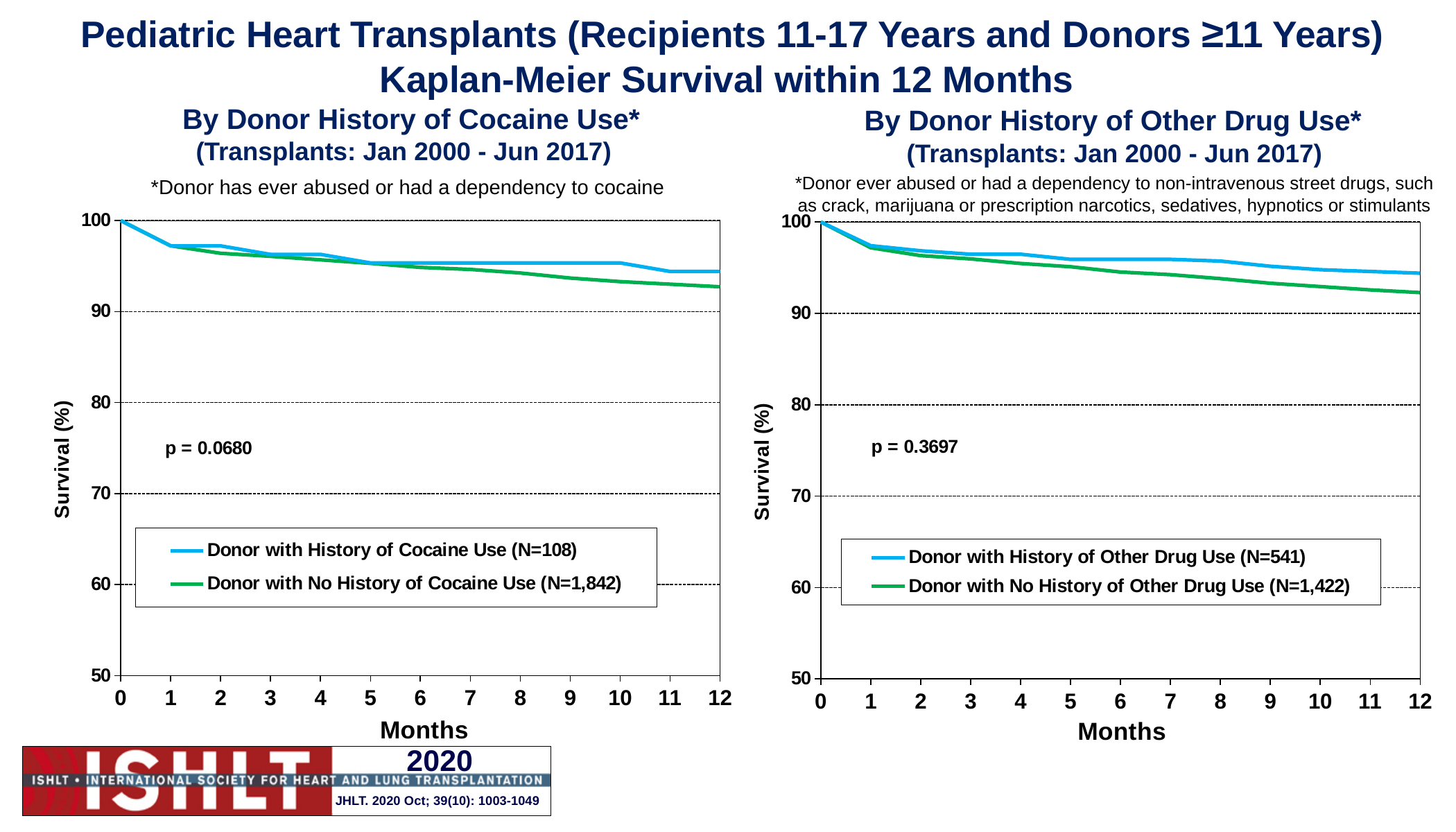
In the right chart, 'By Donor History of Other Drug Use', which series has the higher survival at 12 months? Donor with History of Other Drug Use (N=541) What p-value is shown on the left chart, 'By Donor History of Cocaine Use'? p = 0.0680 In the left chart, 'By Donor History of Cocaine Use', what is the survival value at month 0 for both series? 100 How many series does the legend of the left chart, 'By Donor History of Cocaine Use', list? 2 In the right chart, 'By Donor History of Other Drug Use', do the survival curves rise or fall as months increase? fall In the right chart, 'By Donor History of Other Drug Use', is the survival value at 12 months for 'Donor with No History of Other Drug Use' greater or less than 90? greater How many series does the legend of the right chart, 'By Donor History of Other Drug Use', list? 2 In the left chart, 'By Donor History of Cocaine Use', is the survival value at 12 months for 'Donor with No History of Cocaine Use' greater or less than 90? greater In the right chart, 'By Donor History of Other Drug Use', is the survival value at 12 months for 'Donor with History of Other Drug Use' greater or less than 90? greater What is the N for 'Donor with No History of Cocaine Use' in the legend of the left chart? N=1,842 What kind of chart is the left chart, 'By Donor History of Cocaine Use'? line chart In the left chart, 'By Donor History of Cocaine Use', do the survival curves rise or fall as months increase? fall